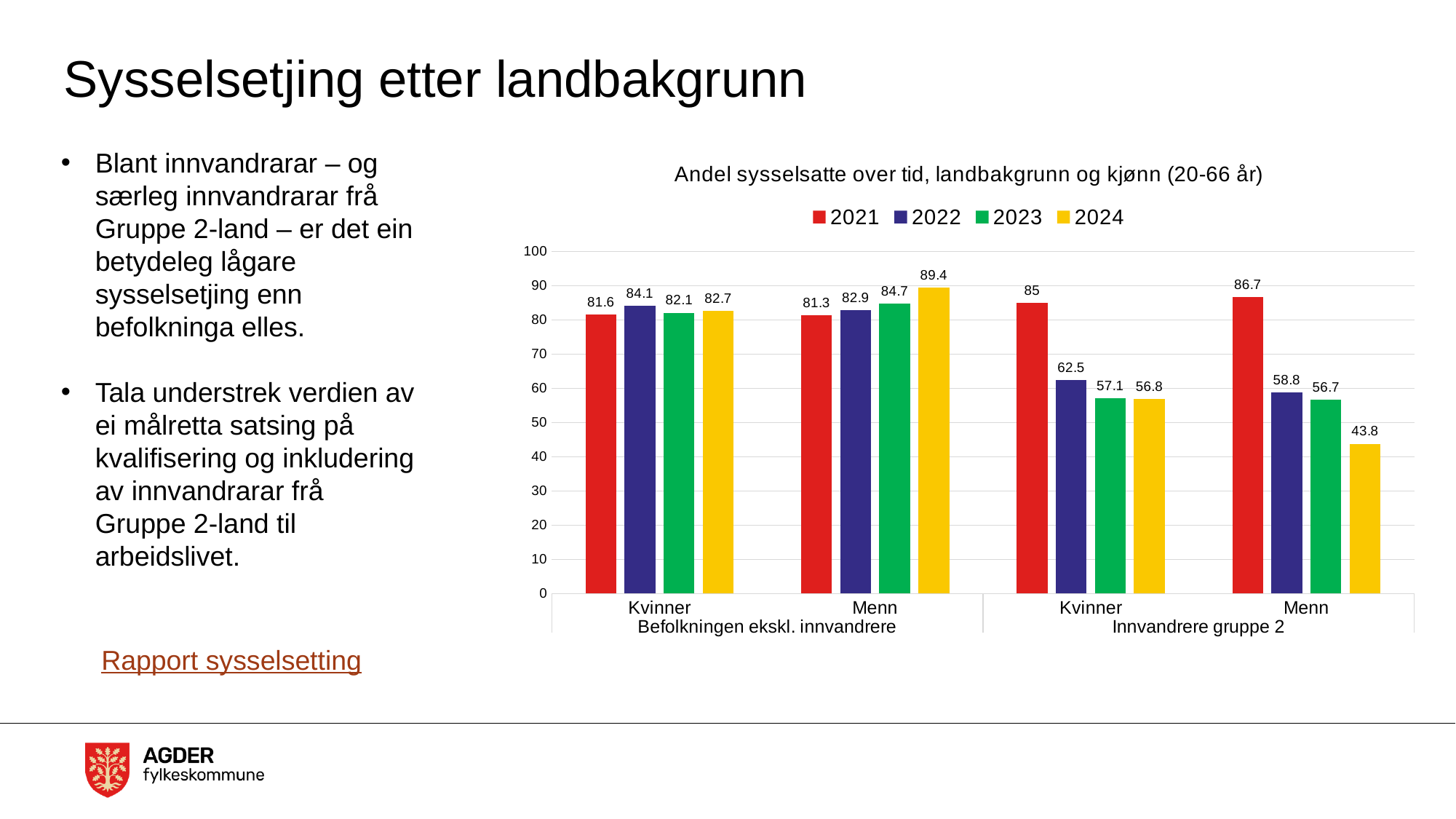
What is the 2024 value for Menn in Innvandrere gruppe 2? 43.8 Do the values for Menn in Innvandrere gruppe 2 rise or fall from 2021 to 2024? Fall What is the difference between the 2021 and 2024 values for Menn in Innvandrere gruppe 2? 42.9 Which is larger: the 2023 value for Kvinner in Innvandrere gruppe 2 or the 2023 value for Menn in Innvandrere gruppe 2? Kvinner (57.1) What is the 2024 value for Menn in Befolkningen ekskl. innvandrere? 89.4 How many series does the legend list? 4 Which group and year has the lowest value in the chart? Menn, Innvandrere gruppe 2, 2024 What is the title of the chart? Andel sysselsatte over tid, landbakgrunn og kjønn (20-66 år) What is the 2021 value for Kvinner in Innvandrere gruppe 2? 85 What is the 2022 value for Kvinner in Befolkningen ekskl. innvandrere? 84.1 What kind of chart is shown on the slide? Bar chart Which group and year has the highest value in the chart? Menn, Befolkningen ekskl. innvandrere, 2024